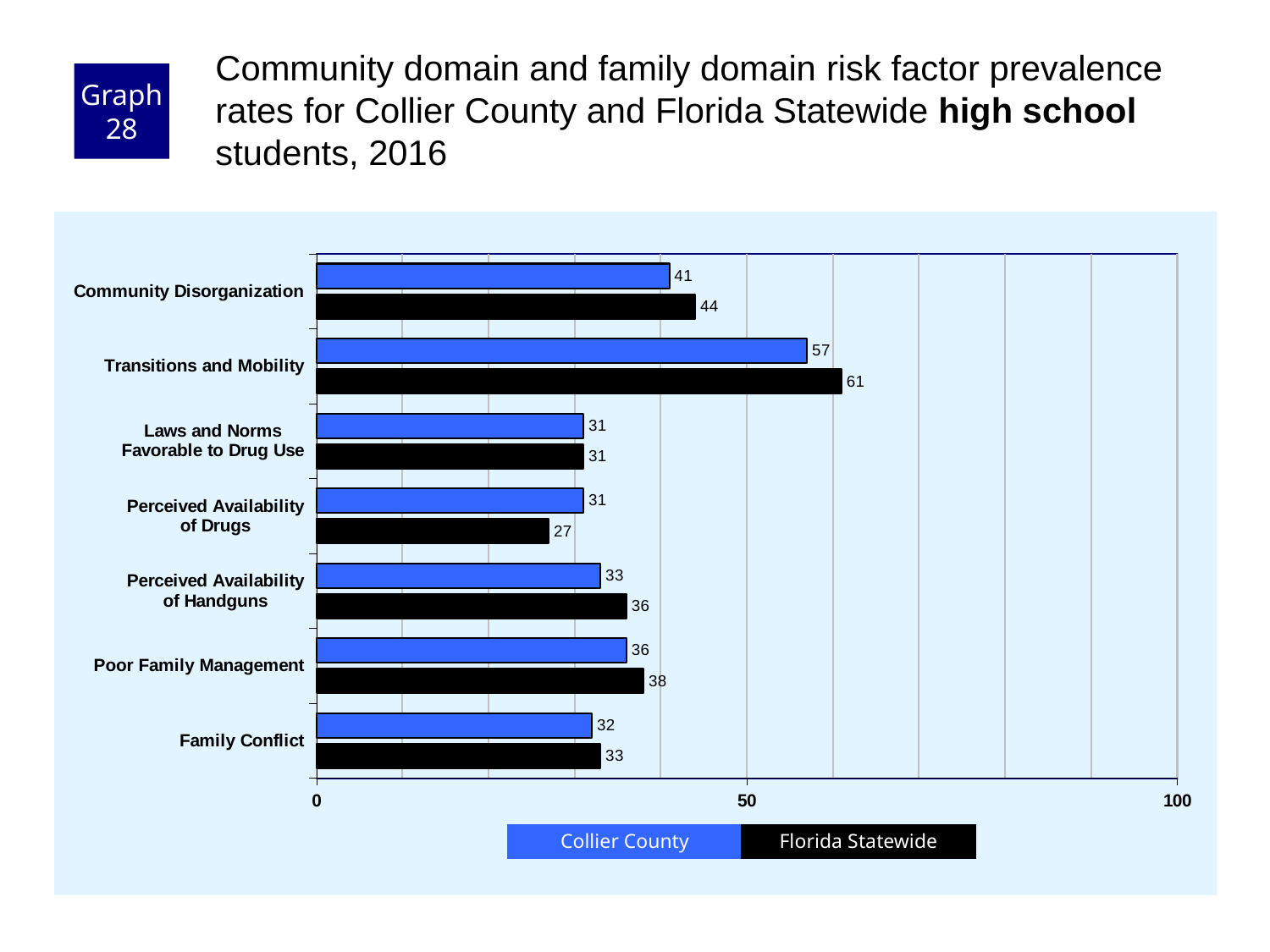
Which colour represents Florida Statewide in the chart? Black What is the Florida Statewide value for Perceived Availability of Drugs? 27 Which is larger for Perceived Availability of Handguns: the Collier County value or the Florida Statewide value? Florida Statewide How many risk factor categories are shown on the chart? 7 Which risk factor has the lowest Collier County value? Laws and Norms Favorable to Drug Use and Perceived Availability of Drugs (both 31) How many series does the legend list? 2 What is the difference between the Florida Statewide and Collier County values for Community Disorganization? 3 Is the Florida Statewide value for Transitions and Mobility greater or less than 50? greater Which risk factor has the highest Florida Statewide value? Transitions and Mobility What kind of chart is shown on the slide? Bar chart What is the Collier County value for Transitions and Mobility? 57 What is the Florida Statewide value for Poor Family Management? 38